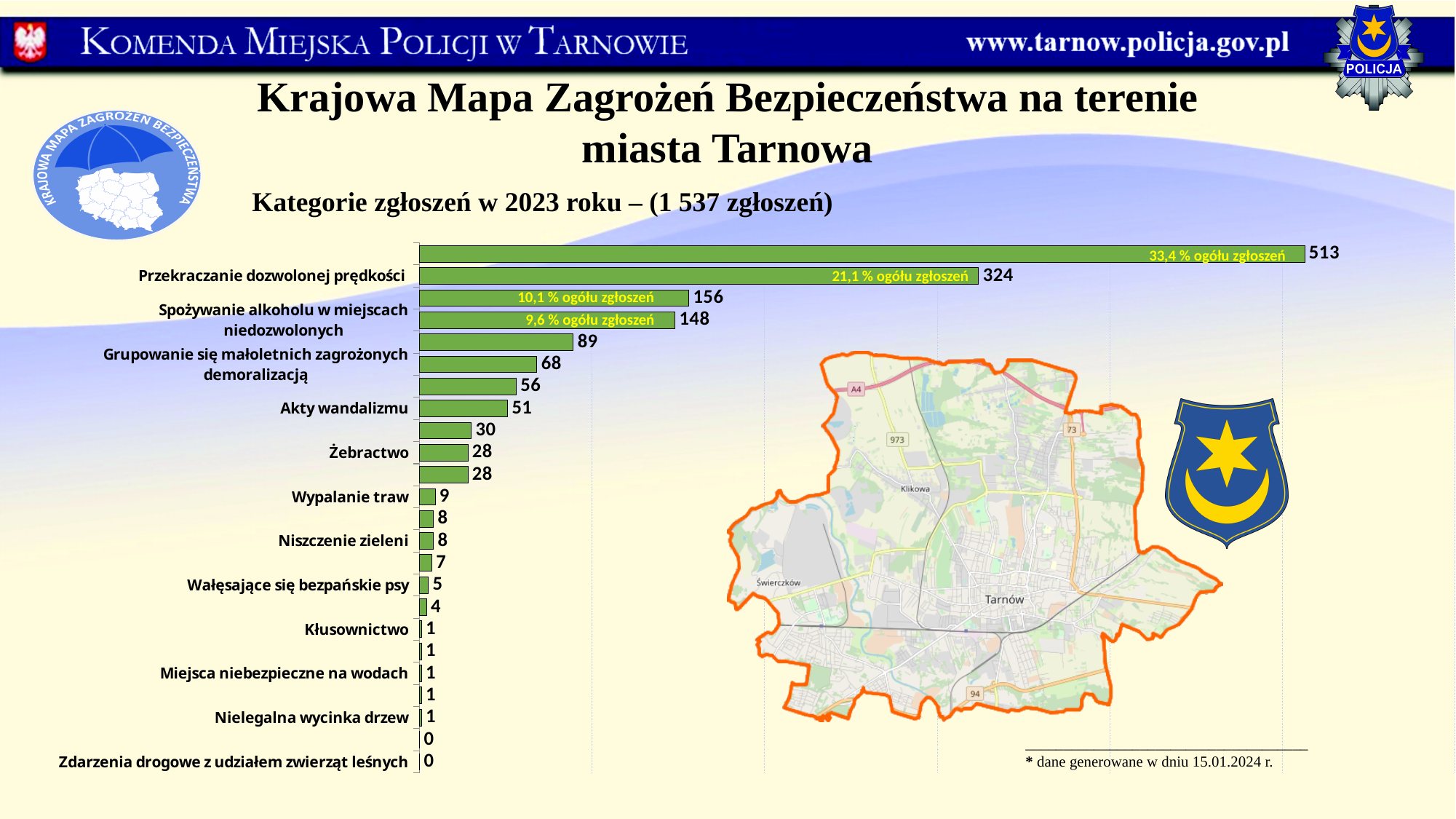
How many bars are plotted on the chart? 24 Which has a larger value: Grupowanie się małoletnich zagrożonych demoralizacją or Akty wandalizmu? Grupowanie się małoletnich zagrożonych demoralizacją What is the difference between the values for Przekraczanie dozwolonej prędkości and Spożywanie alkoholu w miejscach niedozwolonych? 176 What kind of chart is shown on the slide? Bar chart What is the highest value shown on the chart? 513 What value is shown for Przekraczanie dozwolonej prędkości? 324 What value is shown for Akty wandalizmu? 51 What value is shown for Spożywanie alkoholu w miejscach niedozwolonych? 148 According to the chart subtitle, how many reports (zgłoszeń) were there in 2023 in total? 1 537 What value is shown for Żebractwo? 28 What percentage label is printed on the bar for Przekraczanie dozwolonej prędkości? 21,1 % ogółu zgłoszeń What value is shown for Zdarzenia drogowe z udziałem zwierząt leśnych? 0